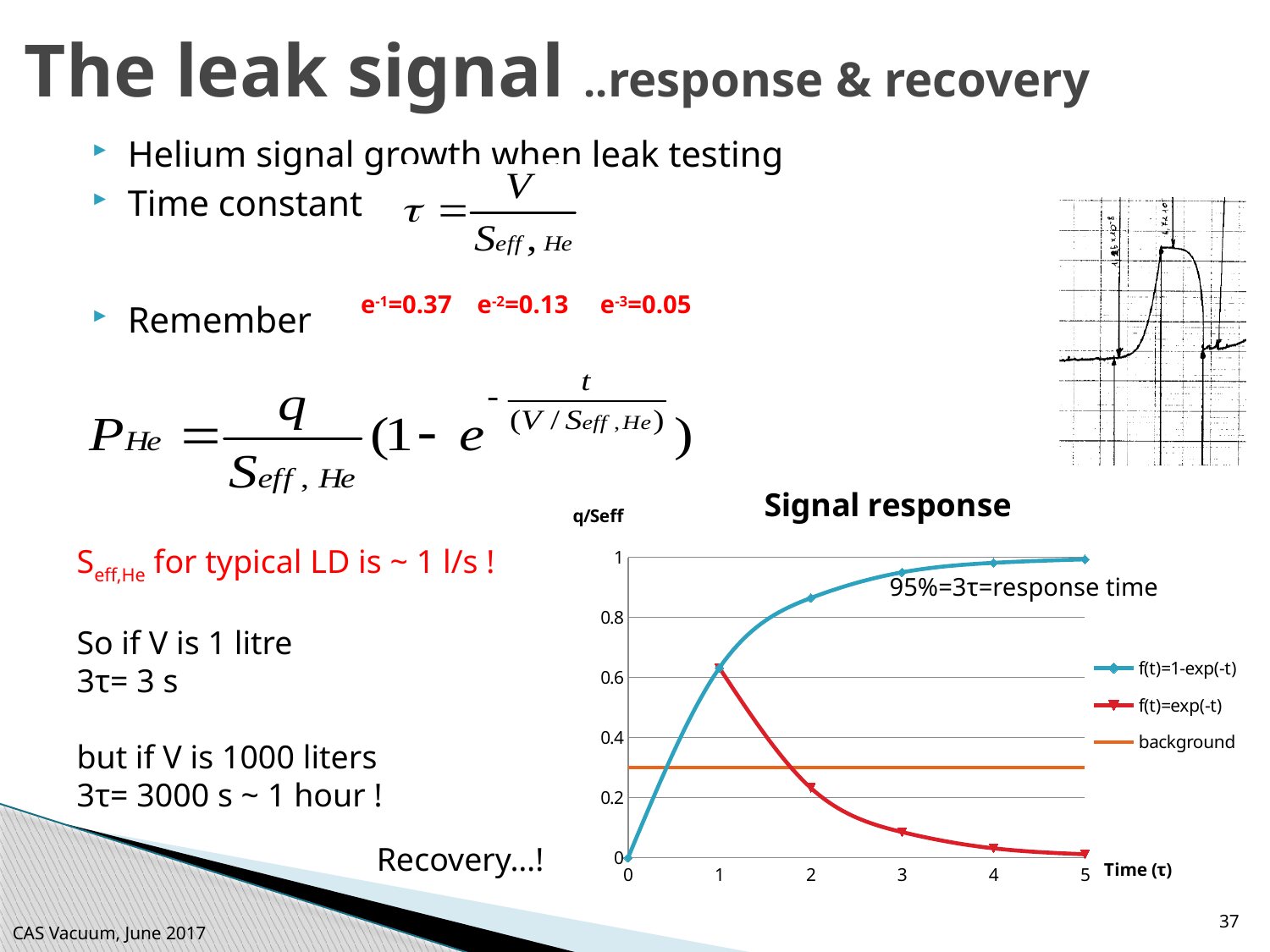
In the 'Signal response' chart, does the series f(t)=1-exp(-t) rise or fall as time increases? rise In the 'Signal response' chart, is the value of f(t)=exp(-t) at time 3 greater or less than 0.2? less In the 'Signal response' chart, what is the value of f(t)=1-exp(-t) at time 0? 0 In the 'Signal response' chart, is the value of f(t)=1-exp(-t) at time 3 greater or less than 0.8? greater In the 'Signal response' chart, is the background level greater or less than 0.2? greater How many series does the legend of the 'Signal response' chart list? 3 In the 'Signal response' chart, at time 2, which series has the larger value: f(t)=1-exp(-t) or f(t)=exp(-t)? f(t)=1-exp(-t) What kind of chart is the 'Signal response' chart? line chart What is the title of the chart on the slide? Signal response What is the label of the x axis of the 'Signal response' chart? Time (τ) In the 'Signal response' chart, does the series f(t)=exp(-t) rise or fall as time increases? fall